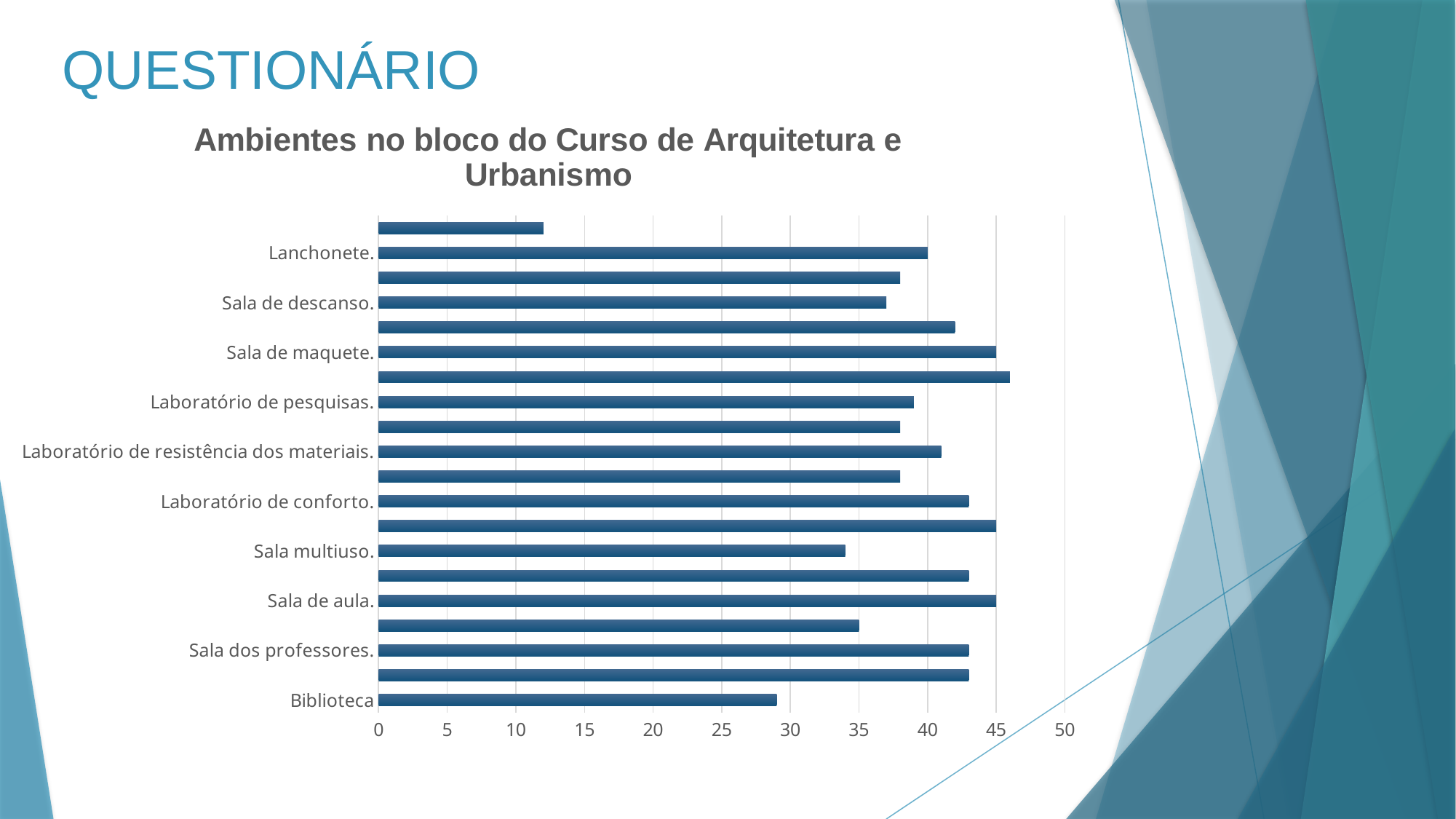
Is the value for Sala multiuso greater or less than 35? less Which has the larger value, Biblioteca or Sala multiuso? Sala multiuso Is the value for Sala de descanso greater or less than 35? greater Is the value for Laboratório de conforto greater or less than 40? greater How many bars are plotted in the chart? 20 What is the title of the chart? Ambientes no bloco do Curso de Arquitetura e Urbanismo How many category labels are shown on the vertical axis of the chart? 10 What kind of chart is shown on the slide? bar chart Which has the larger value, Sala multiuso or Laboratório de conforto? Laboratório de conforto What is the highest value shown on the horizontal axis of the chart? 50